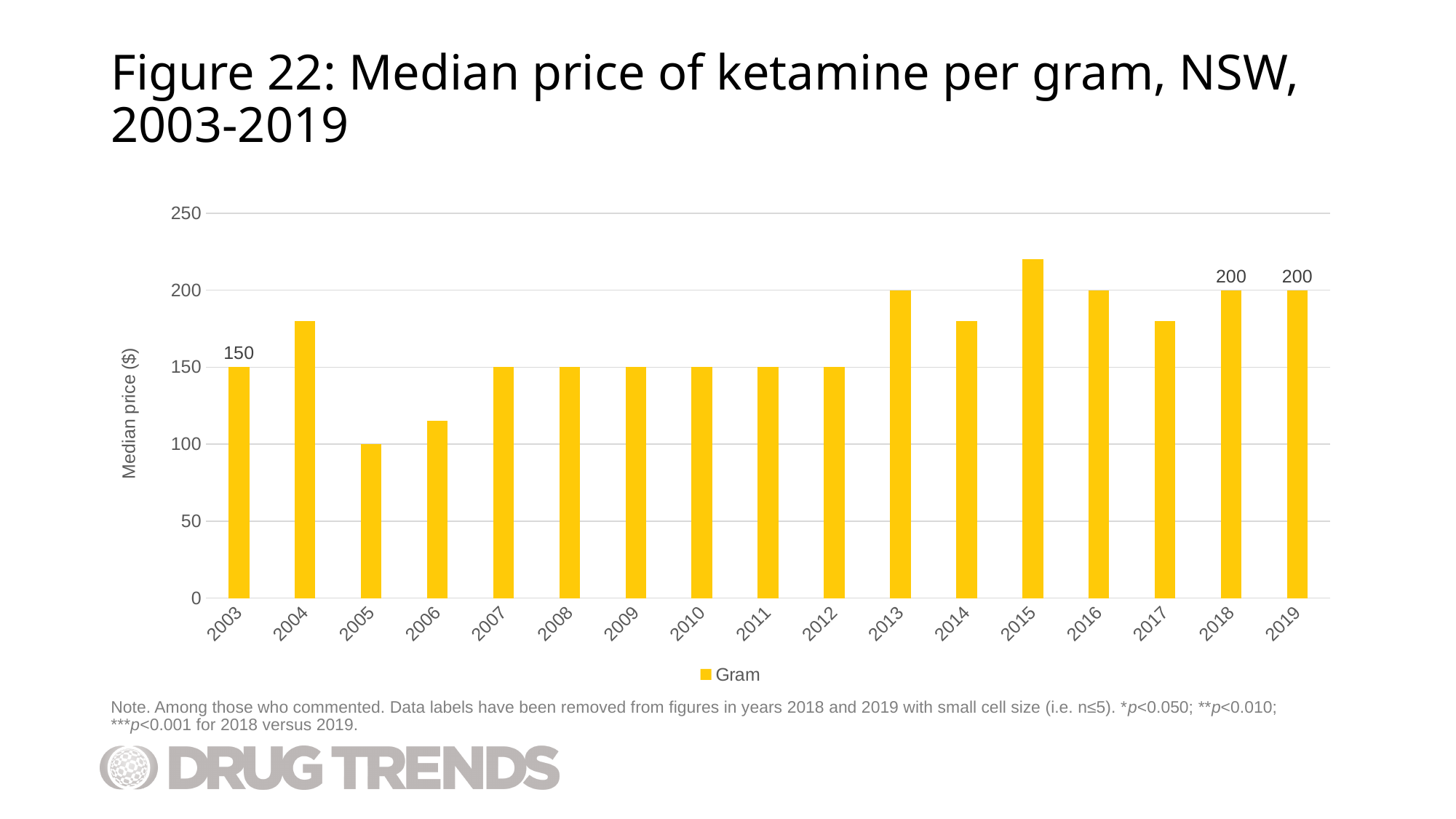
What is the median price of ketamine per gram in NSW in 2018? 200 Which year has the lowest median price of ketamine per gram? 2005 How many series does the legend list? 1 Which year has a higher median price, 2003 or 2018? 2018 Which year has the highest median price of ketamine per gram? 2015 What is the median price of ketamine per gram in NSW in 2003? 150 What is the difference between the median price in 2019 and in 2003? 50 What kind of chart is shown on the slide? Bar chart Is the median price for 2004 greater or less than 150? greater Is the median price for 2015 greater or less than 200? greater How many years are shown on the x axis of the chart? 17 What is the median price of ketamine per gram in NSW in 2019? 200